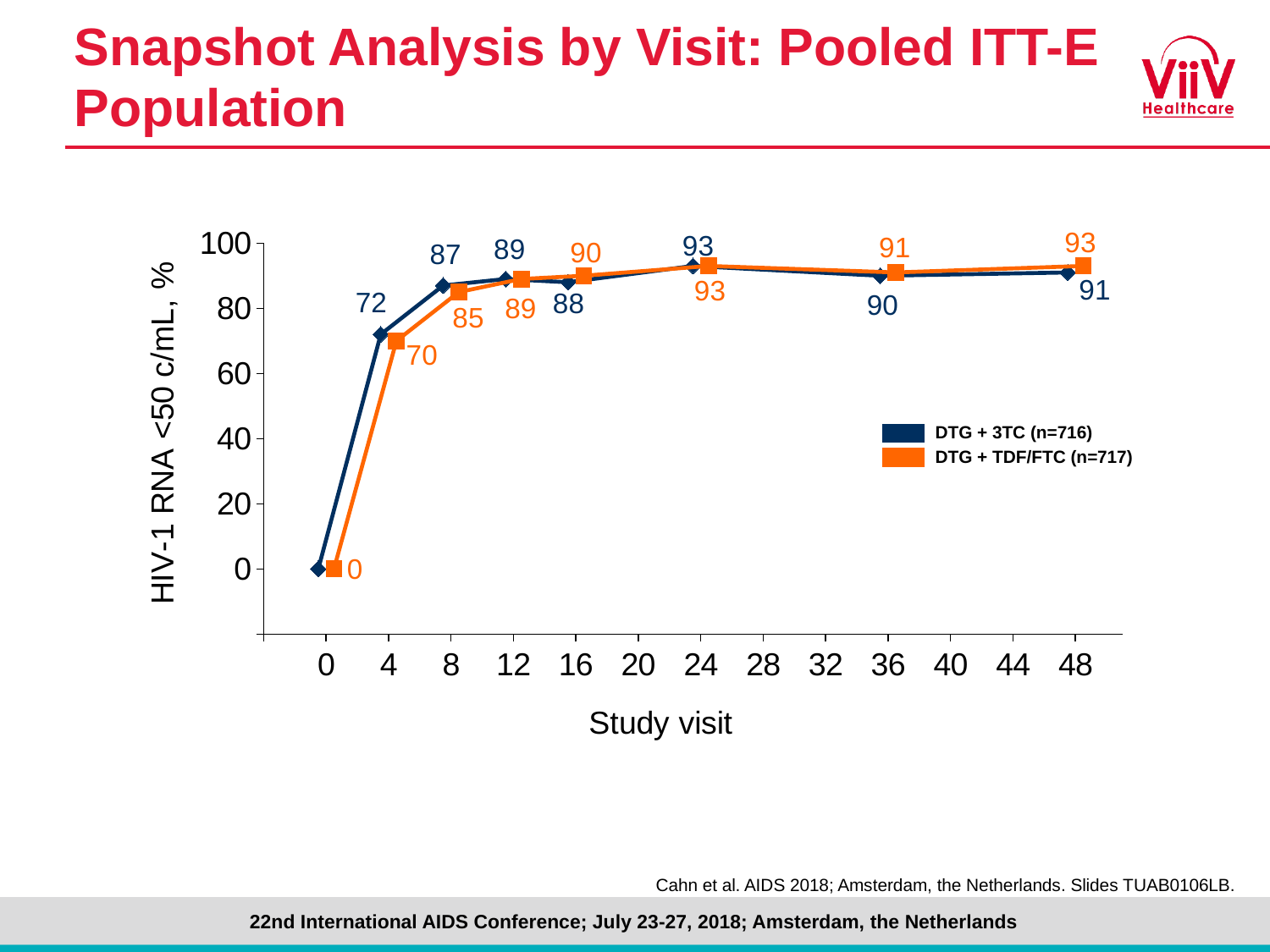
What is the value for DTG + 3TC at study visit week 4? 72 Is the value for DTG + 3TC at week 8 greater or less than 80? greater Does the DTG + TDF/FTC line rise or fall between week 0 and week 8? rise Which series has the higher value at week 16, DTG + 3TC or DTG + TDF/FTC? DTG + TDF/FTC What is the value for DTG + 3TC at study visit week 48? 91 What is the label of the y axis? HIV-1 RNA <50 c/mL, % What is the value for DTG + TDF/FTC at study visit week 48? 93 What is the difference between the DTG + 3TC and DTG + TDF/FTC values at week 4? 2 How many series does the legend list? 2 What type of chart is shown on the slide? line chart At which study visit does DTG + 3TC reach its highest value? 24 What is the value for DTG + TDF/FTC at study visit week 8? 85